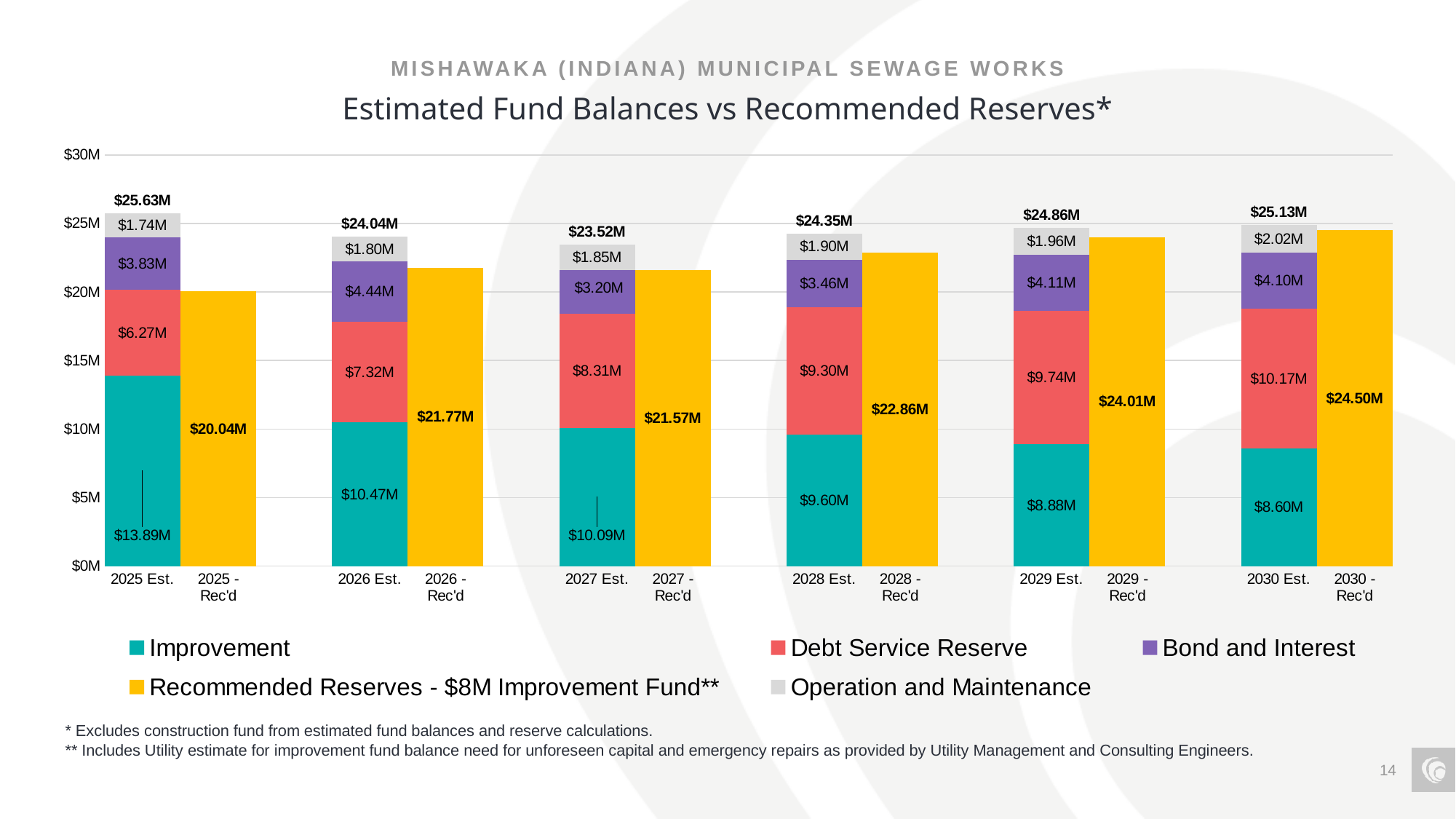
Which is larger for 2029 Est., Debt Service Reserve or Improvement? Debt Service Reserve What kind of chart is shown on the slide? stacked bar chart How many series does the legend list? 5 What is the difference between the 2025 Est. total and the 2025 - Rec'd value? $5.59M What is the Recommended Reserves value for 2028 - Rec'd? $22.86M Which Rec'd bar has the lowest Recommended Reserves value? 2025 - Rec'd What is the Operation and Maintenance value for 2030 Est.? $2.02M How many bars are shown on the x axis? 12 Which year's Est. bar has the highest Improvement value? 2025 Est. What is the total estimated fund balance for 2025 Est.? $25.63M What is the Improvement value for 2026 Est.? $10.47M Do the Recommended Reserves values rise or fall from 2025 - Rec'd to 2030 - Rec'd? rise